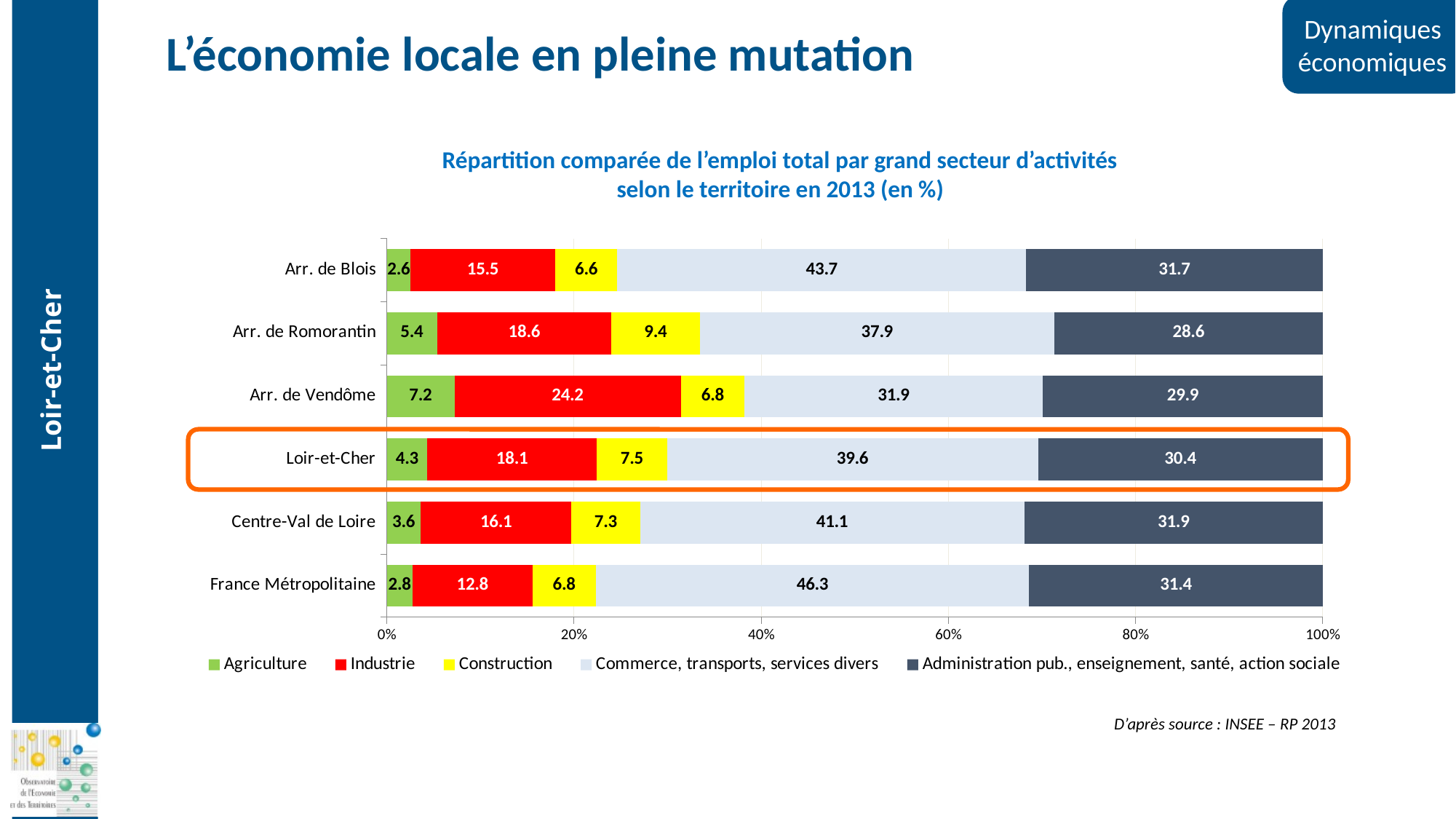
Which is larger, the Commerce, transports, services divers value for Arr. de Blois or for Loir-et-Cher? Arr. de Blois What is the difference between the Construction values for Arr. de Romorantin and Arr. de Blois? 2.8 What is the difference between the Administration pub., enseignement, santé, action sociale values for Centre-Val de Loire and Arr. de Romorantin? 3.3 Which territory has the lowest Industrie value? France Métropolitaine How many series does the legend list? 5 Which territory has the highest Agriculture value? Arr. de Vendôme How many territories are shown on the chart? 6 What is the Agriculture value for Loir-et-Cher? 4.3 Which series is shown in red? Industrie What is the Industrie value for Arr. de Vendôme? 24.2 What is the Commerce, transports, services divers value for France Métropolitaine? 46.3 What kind of chart is shown on the slide? Stacked bar chart